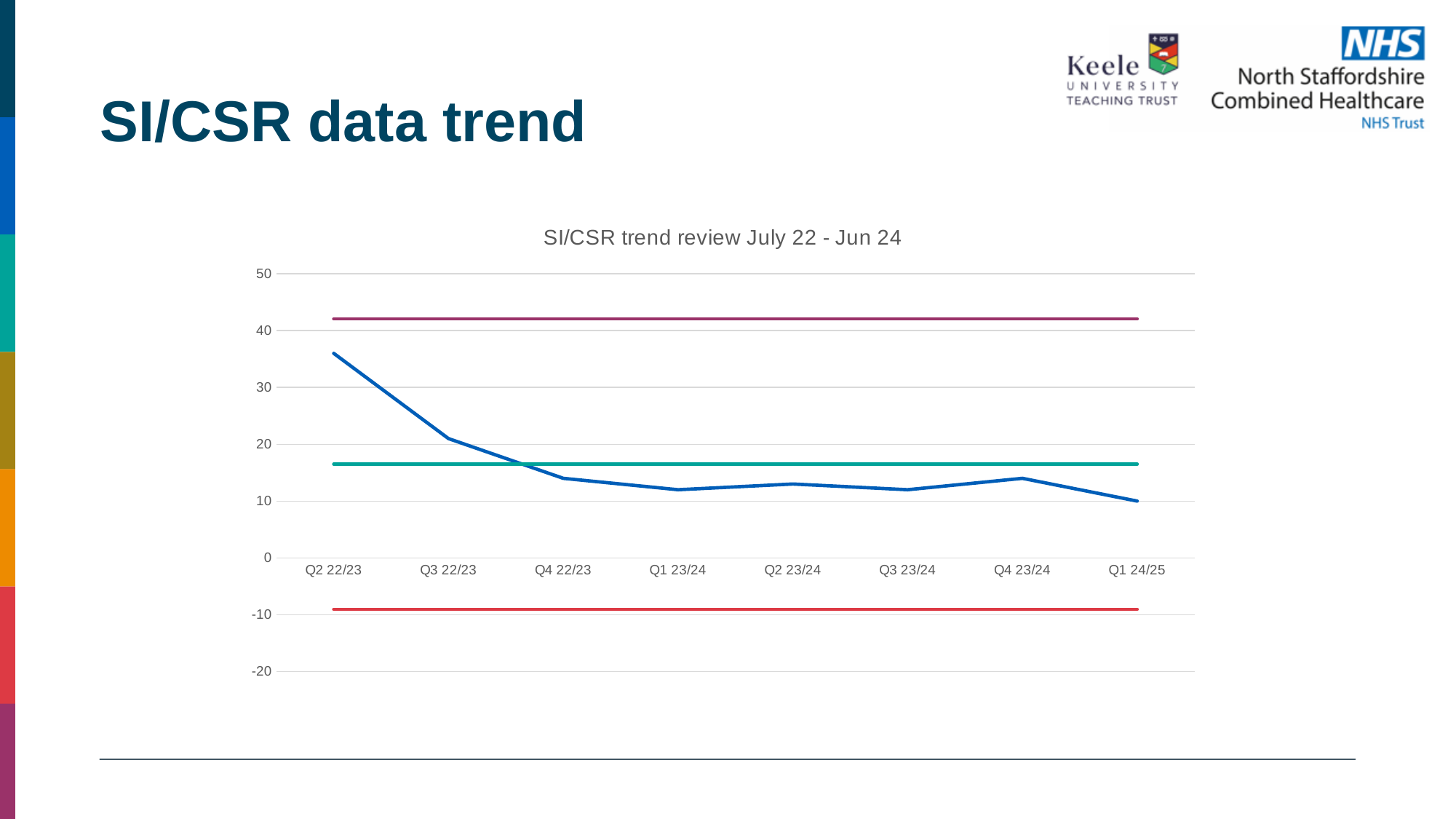
Does the blue line generally rise or fall from Q2 22/23 to Q1 24/25? fall How many quarters are plotted along the x axis? 8 Is the value for Q1 23/24 greater or less than 10? greater Which quarter has the lowest value on the blue line? Q1 24/25 Which is larger, the value for Q3 22/23 or the value for Q4 23/24? Q3 22/23 Which quarter has the highest value on the blue line? Q2 22/23 What is the title of the chart? SI/CSR trend review July 22 - Jun 24 Which is larger, the value for Q2 22/23 or the value for Q3 22/23? Q2 22/23 Is the value for Q4 22/23 greater or less than 20? less What type of chart is shown on the slide? line chart Is the value for Q2 22/23 greater or less than 30? greater